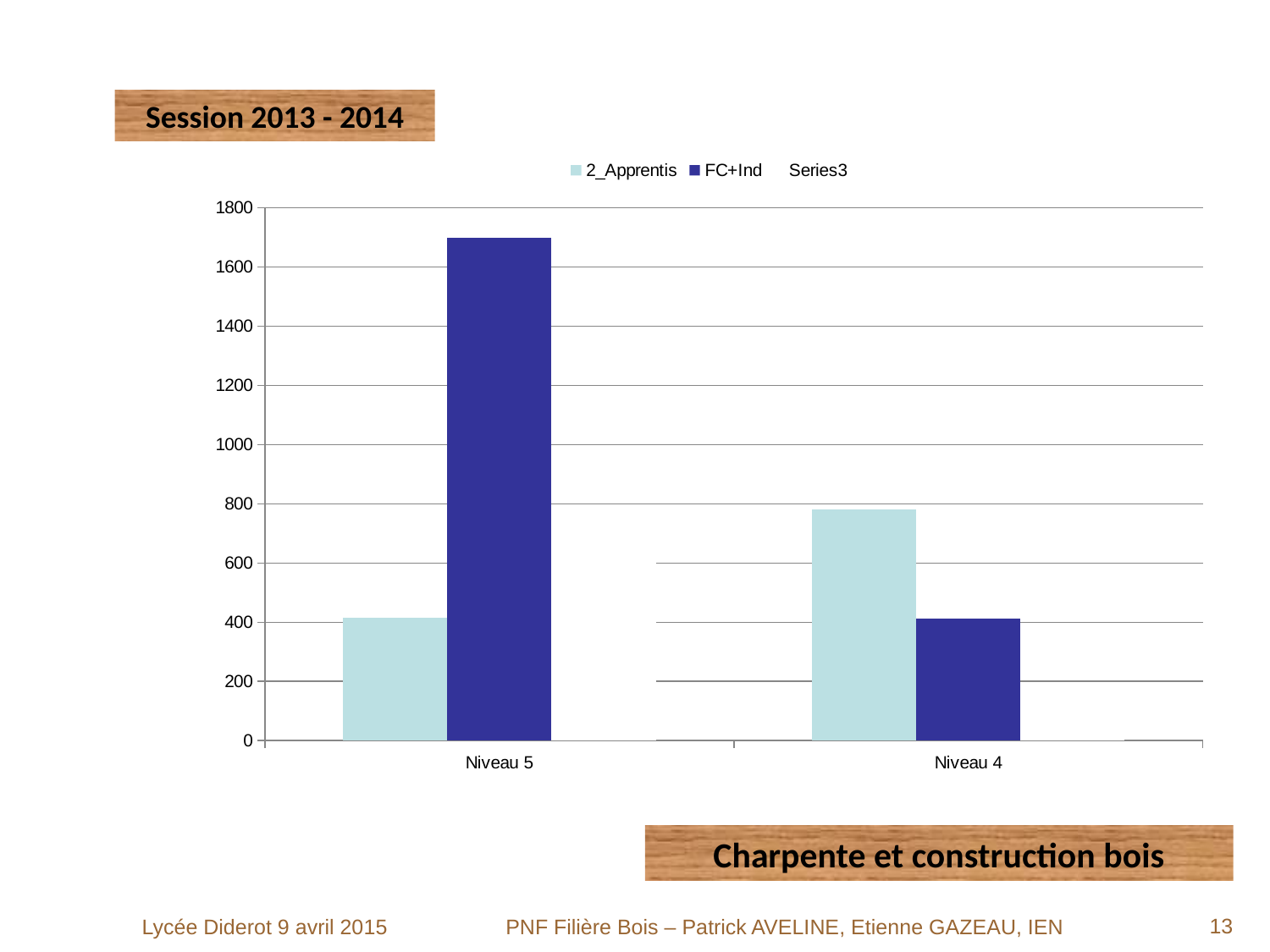
How many series does the legend list? 3 Which series and category has the tallest bar in the chart? FC+Ind at Niveau 5 Is the 2_Apprentis value for Niveau 5 greater or less than 600? less For Niveau 5, which series has the larger value, 2_Apprentis or FC+Ind? FC+Ind What kind of chart is shown on the slide? bar chart How many categories are shown on the x axis? 2 For the 2_Apprentis series, which category has the larger value, Niveau 5 or Niveau 4? Niveau 4 What are the names of the series listed in the legend? 2_Apprentis, FC+Ind, Series3 For Niveau 4, which series has the larger value, 2_Apprentis or FC+Ind? 2_Apprentis Is the 2_Apprentis value for Niveau 4 greater or less than 600? greater Is the FC+Ind value for Niveau 4 greater or less than 600? less